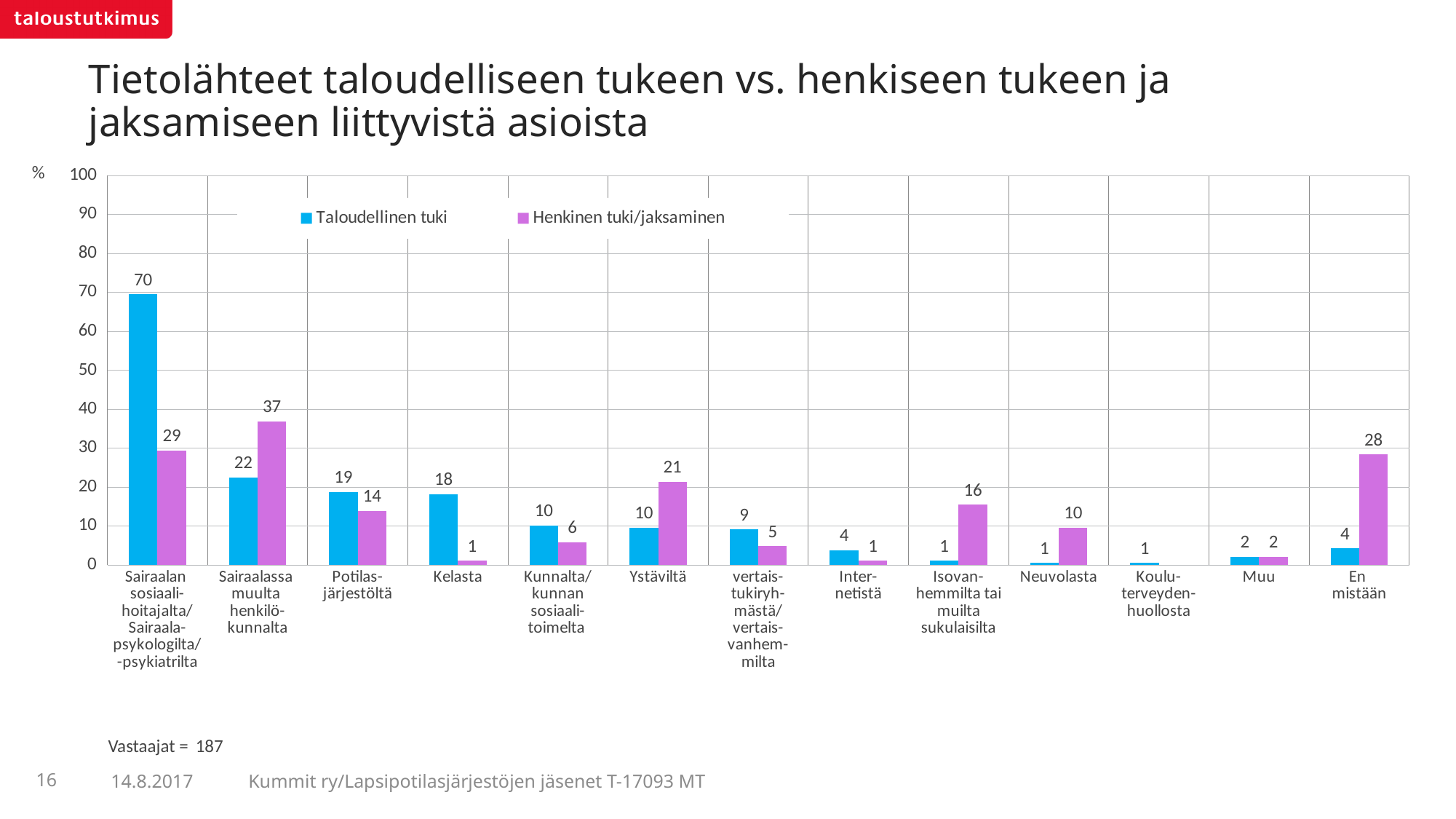
What is the value for Taloudellinen tuki in the Kelasta category? 18 How many series does the legend list? 2 What is the value for Henkinen tuki/jaksaminen in the En mistään category? 28 In the Sairaalan sosiaalihoitajalta/Sairaalapsykologilta/-psykiatrilta category, what is the difference between Taloudellinen tuki and Henkinen tuki/jaksaminen? 41 Which category has the highest value for Henkinen tuki/jaksaminen? Sairaalassa muulta henkilökunnalta What kind of chart is shown on the slide? Bar chart Which category has the highest value for Taloudellinen tuki? Sairaalan sosiaalihoitajalta/Sairaalapsykologilta/-psykiatrilta In the Sairaalassa muulta henkilökunnalta category, how much higher is Henkinen tuki/jaksaminen than Taloudellinen tuki? 15 What colour represents Taloudellinen tuki in the legend? Blue What is the value for Henkinen tuki/jaksaminen in the Isovanhemmilta tai muilta sukulaisilta category? 16 In the Ystäviltä category, which series has the larger value? Henkinen tuki/jaksaminen How many categories are shown on the x axis? 13